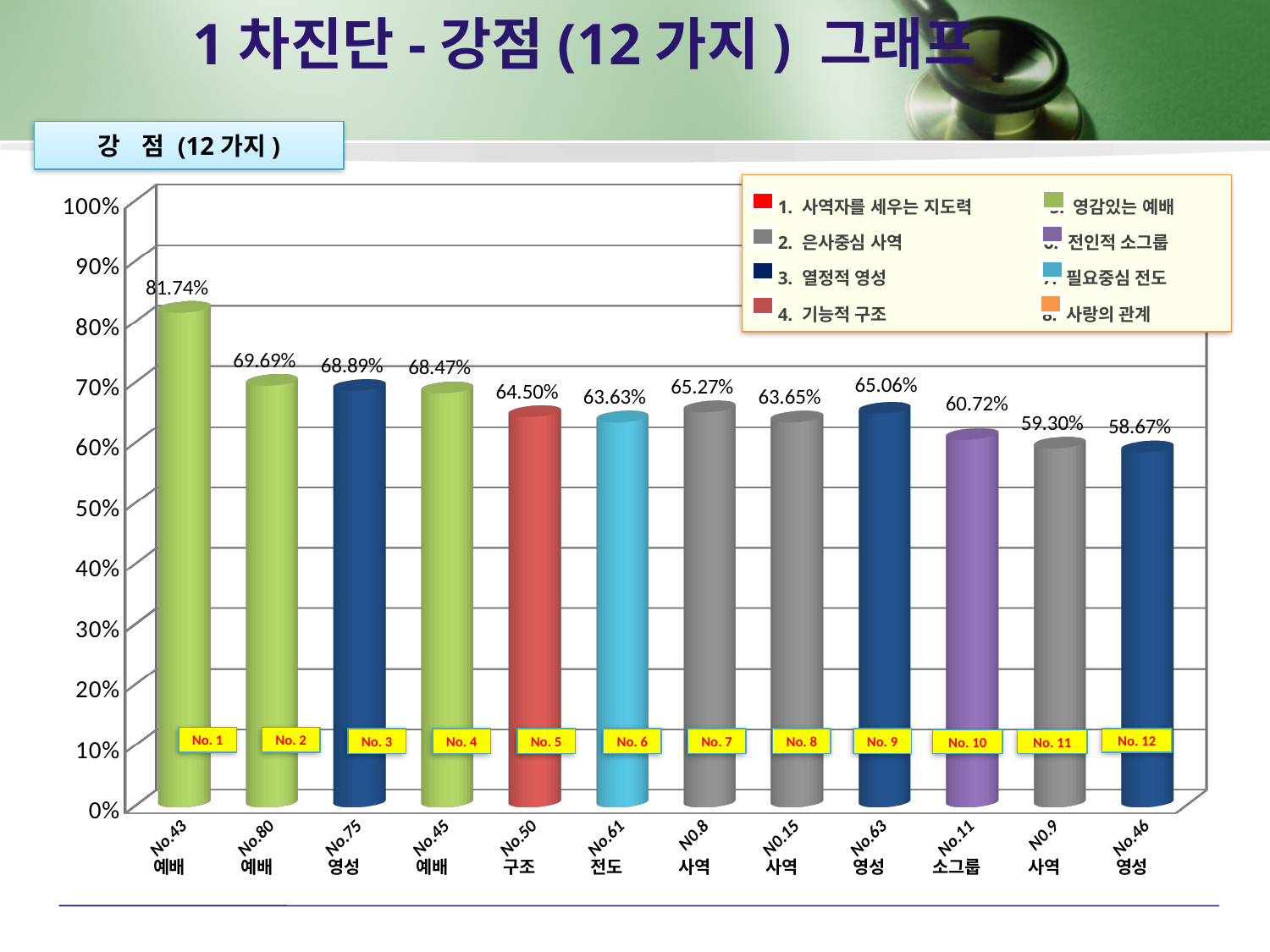
How many bars are plotted in the chart? 12 What is the difference between the values for No.63 영성 and No.46 영성? 6.39% Which is larger, the value for No.75 영성 or the value for No.45 예배? No.75 영성 Which category has the lowest value? No.46 영성 How many entries does the legend list? 8 What is the value for No.11 소그룹 (No. 10)? 60.72% What is the value for No.50 구조 (No. 5)? 64.50% What is the value for No.43 예배 (No. 1)? 81.74% What is the difference between the values for No.43 예배 and No.80 예배? 12.05% Which category has the highest value? No.43 예배 Is the value for No.61 전도 greater or less than 70%? less What kind of chart is shown on the slide? bar chart